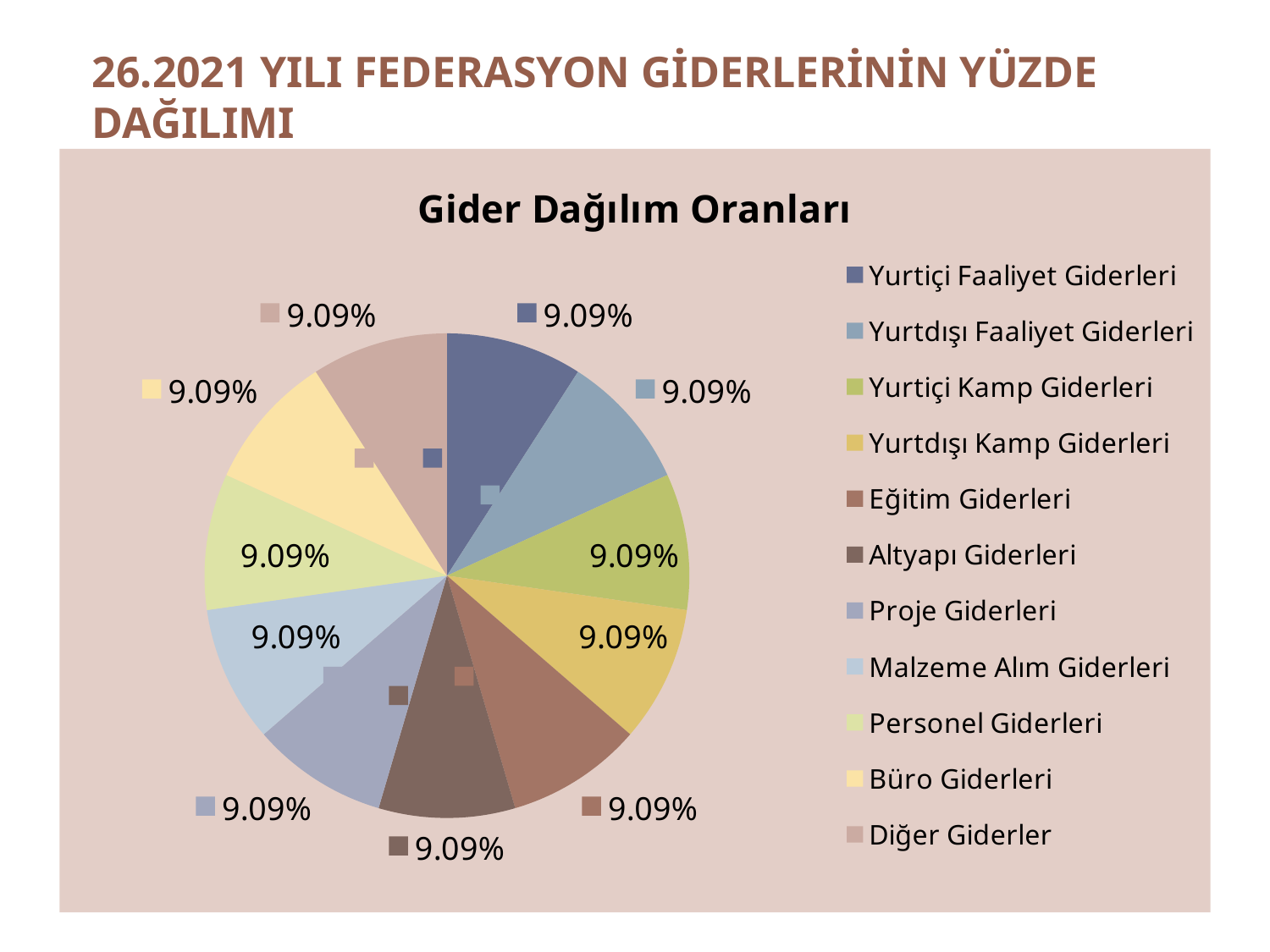
What is the title of the chart? Gider Dağılım Oranları What kind of chart is shown on the slide? pie chart How many slices does the pie chart have? 11 What share of the pie is Personel Giderleri? 9.09% What is the value shown for Malzeme Alım Giderleri? 9.09% What is the value shown for Yurtdışı Kamp Giderleri? 9.09% What is the value shown for Eğitim Giderleri? 9.09% What is the value shown for Diğer Giderler? 9.09% How many entries does the legend list? 11 Which legend entry is listed last? Diğer Giderler What share of the pie is Yurtiçi Faaliyet Giderleri? 9.09% What is the difference between the values for Proje Giderleri and Büro Giderleri? 0%